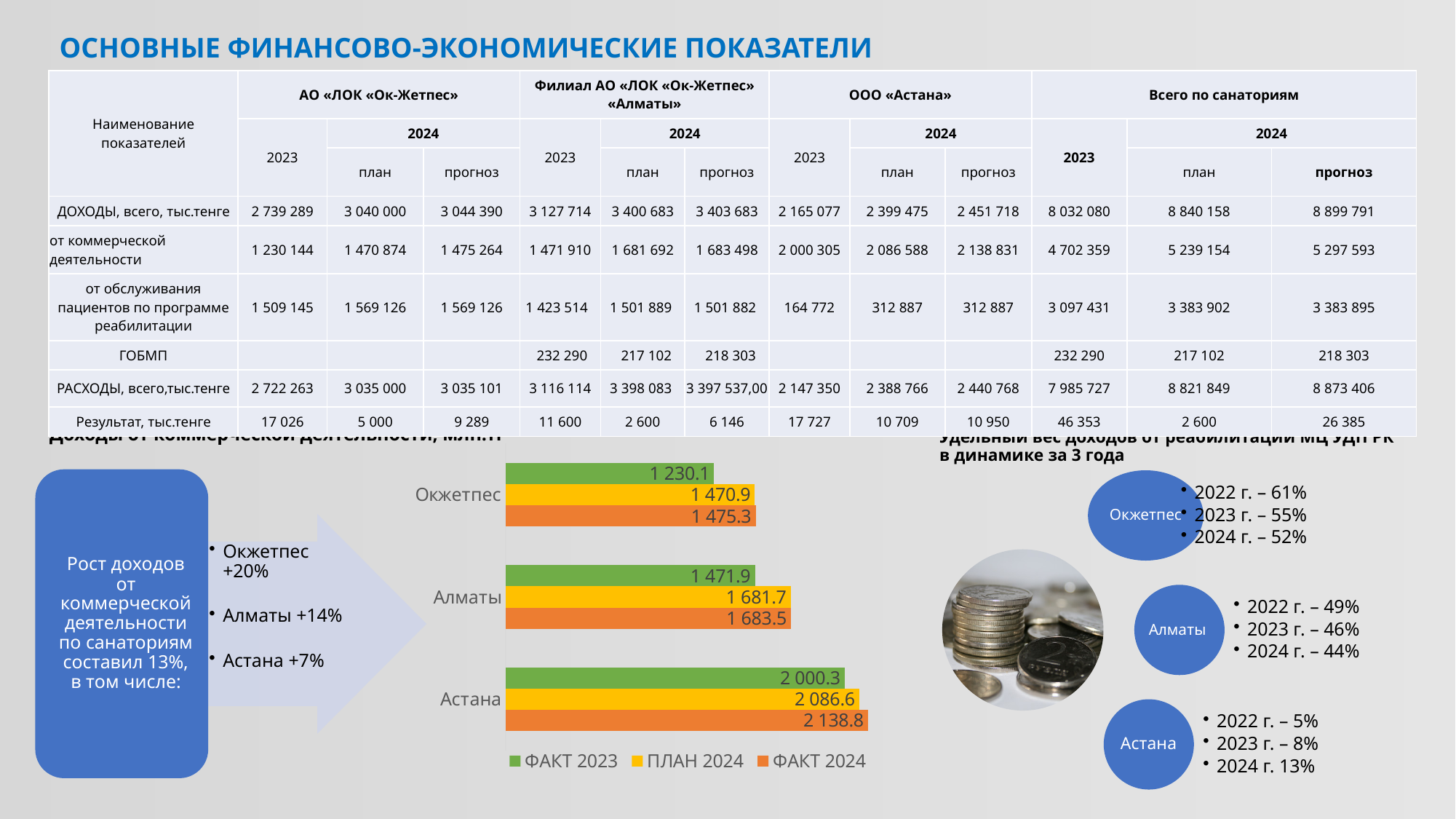
What is the ПЛАН 2024 value for Алматы in the bar chart? 1 681.7 What colour represents the ФАКТ 2024 series in the bar chart? Orange What type of chart is shown on the slide? Bar chart In the bar chart, what is the difference between the ФАКТ 2024 and ФАКТ 2023 values for Окжетпес? 245.2 What is the ФАКТ 2024 value for Астана in the bar chart? 2 138.8 How many series does the legend of the bar chart list? 3 In the bar chart, how much larger is the ФАКТ 2024 value for Астана than its ПЛАН 2024 value? 52.2 How many categories are shown in the bar chart? 3 Which category has the lowest ФАКТ 2023 value in the bar chart? Окжетпес Which category has the highest ФАКТ 2024 value in the bar chart? Астана In the bar chart, which is larger: the ФАКТ 2024 value for Алматы or the ФАКТ 2023 value for Астана? ФАКТ 2023 value for Астана What is the ФАКТ 2023 value for Окжетпес in the bar chart? 1 230.1